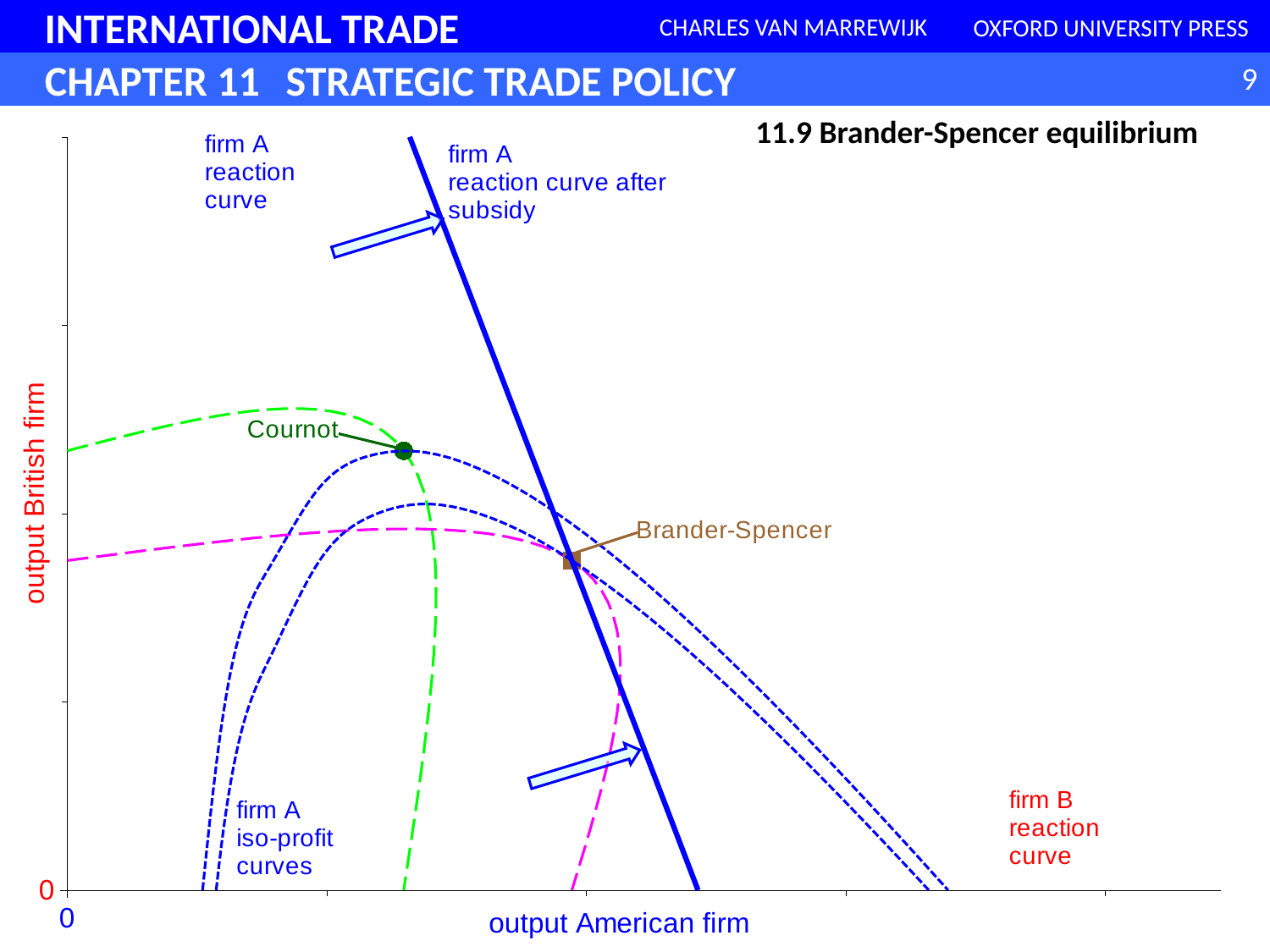
Which equilibrium point has the larger output of the American firm, Cournot or Brander-Spencer? Brander-Spencer How many labelled equilibrium points are marked on the chart? 2 What is the label of the horizontal axis of the chart? output American firm Which point lies on the firm A reaction curve after subsidy, Cournot or Brander-Spencer? Brander-Spencer Which equilibrium point has the larger output of the British firm, Cournot or Brander-Spencer? Cournot How many firm A iso-profit curves are drawn on the chart? 2 What is the title of the chart on the slide? 11.9 Brander-Spencer equilibrium Does the firm B reaction curve rise or fall as the output of the American firm increases? fall How many reaction curves for firm A are drawn on the chart (before and after subsidy)? 2 What kind of chart is shown on the slide? line chart